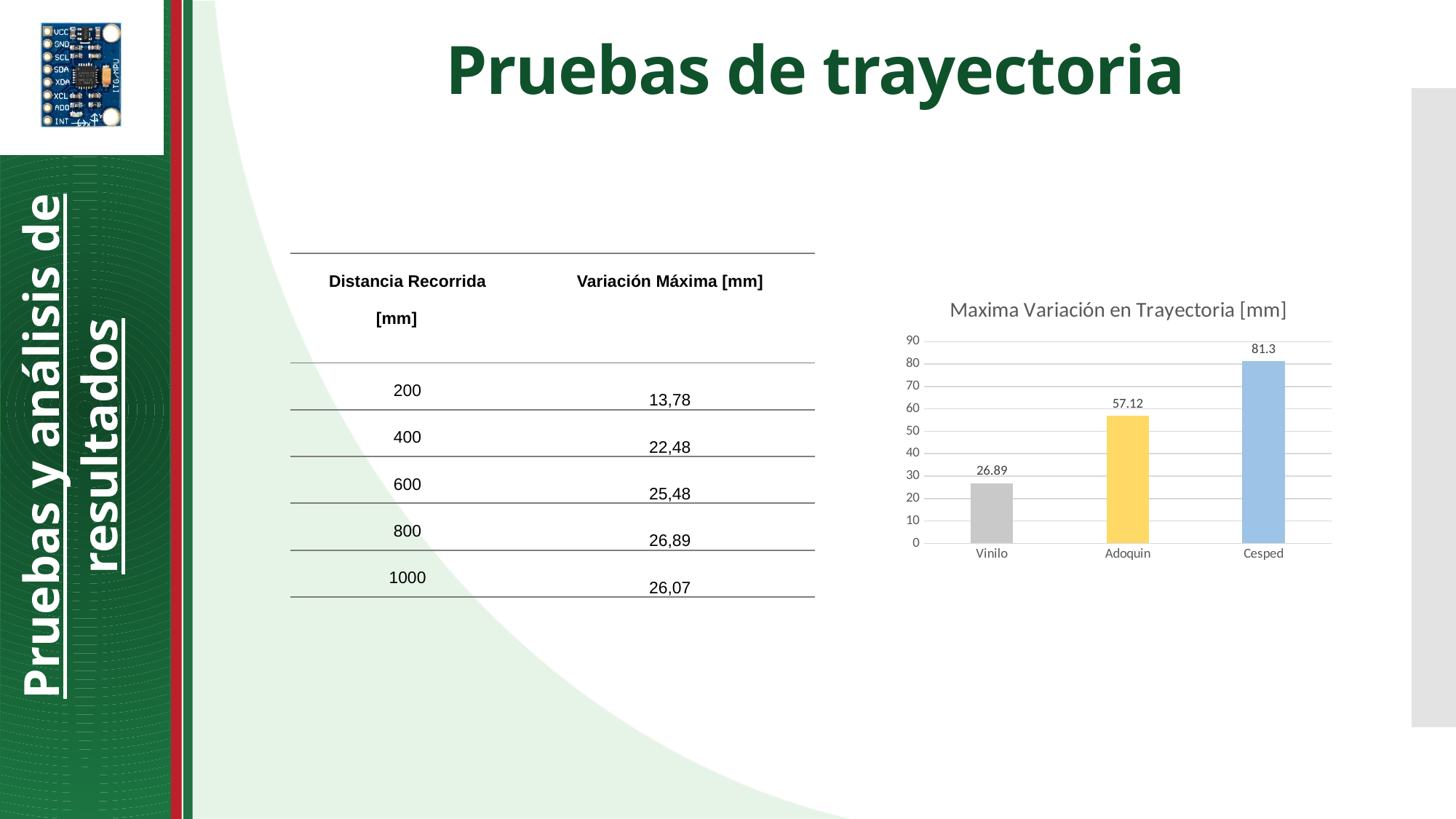
Which category has the highest value in the chart? Cesped What is the difference between the values for Cesped and Adoquin? 24.18 What is the value for Vinilo in the chart? 26.89 What is the value for Cesped in the chart? 81.3 Is the value for Cesped greater or less than 80? greater Which category has the lowest value in the chart? Vinilo What is the title of the chart? Maxima Variación en Trayectoria [mm] How many categories are shown in the chart? 3 What is the value for Adoquin in the chart? 57.12 What kind of chart is shown on the slide? bar chart Which is larger, the value for Adoquin or the value for Vinilo? Adoquin What is the difference between the values for Adoquin and Vinilo? 30.23